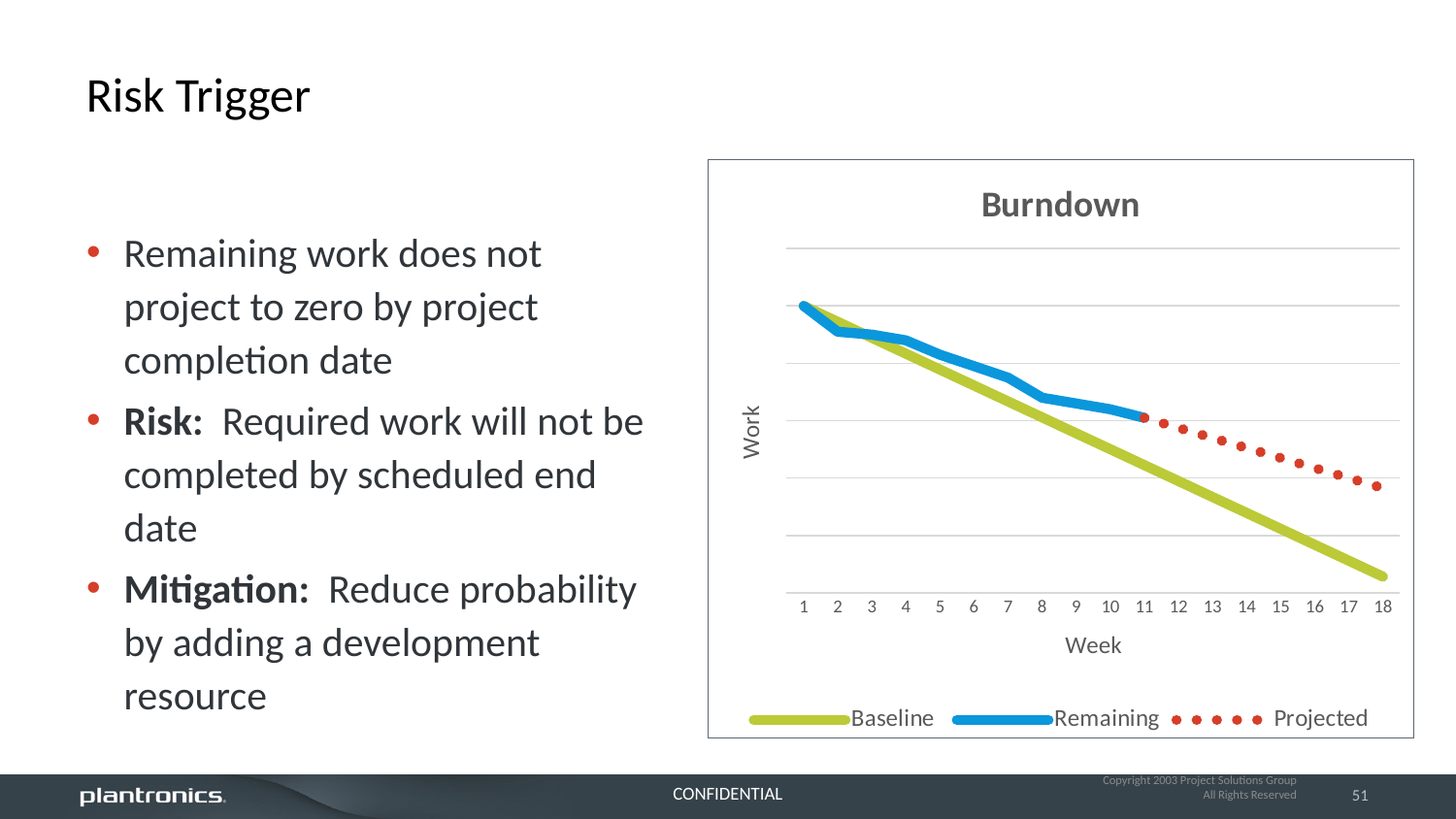
What is the title of the chart? Burndown What is the label of the y axis? Work Does the Baseline series rise or fall as the week number increases? Fall How many series does the chart's legend list? 3 At week 18, which series has the higher value, Baseline or Projected? Projected How many weeks are shown on the x axis of the chart? 18 What kind of chart is shown on the slide? Line chart At which week does the Remaining series end and the Projected series begin? Week 11 Does the Remaining series rise or fall from week 1 to week 11? Fall At week 8, which series has the higher value, Remaining or Baseline? Remaining